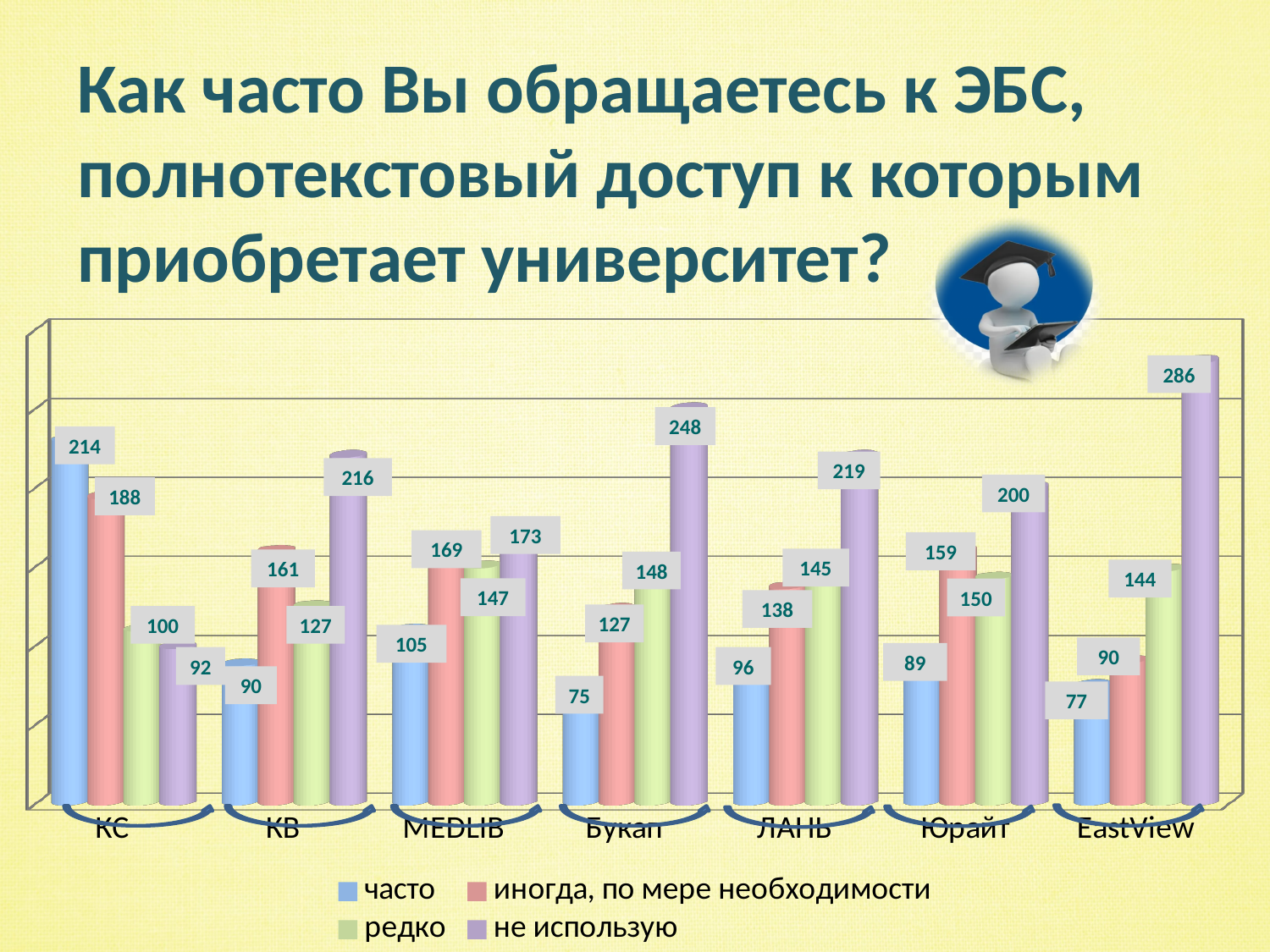
What is the value for 'иногда, по мере необходимости' for Юрайт? 159 What is the difference between the 'не использую' value for Букап and the 'не использую' value for ЛАНЬ? 29 Which series is shown in purple in the legend? не использую What is the value for 'часто' for КС? 214 What type of chart is shown on the slide? bar chart What is the value for 'не использую' for EastView? 286 How many categories (electronic library systems) are shown on the x axis? 7 How many series does the legend list? 4 Which is larger for MEDLIB: the 'иногда, по мере необходимости' value or the 'не использую' value? не использую Which category has the highest value for 'не использую'? EastView Which category has the lowest value for 'часто'? Букап What is the value for 'редко' for Букап? 148